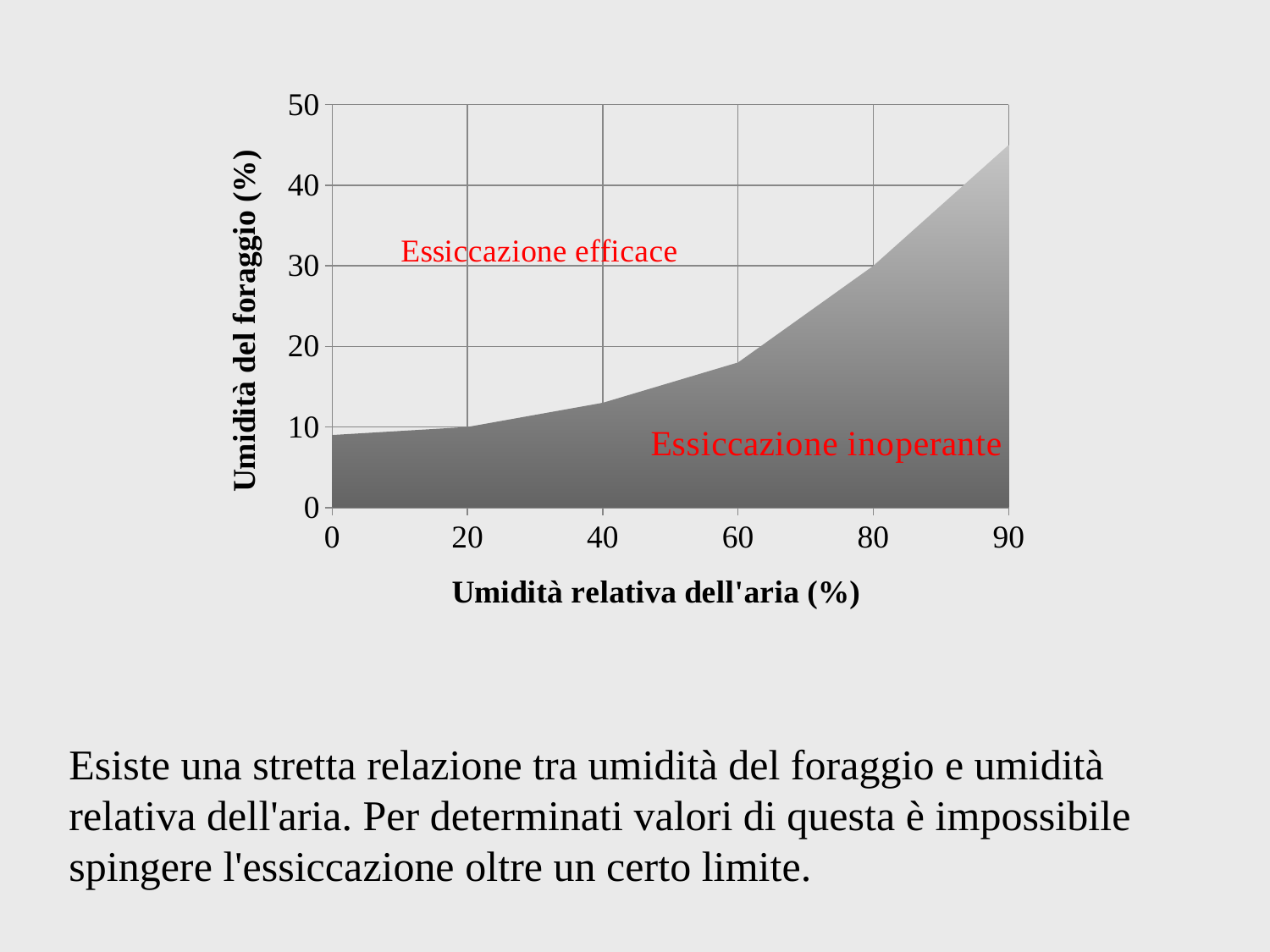
Is the forage humidity value at 90% relative air humidity greater or less than 40? greater Does the forage humidity (Umidità del foraggio) rise or fall as relative air humidity increases along the x axis? rise Is the forage humidity value at 80% relative air humidity greater or less than 40? less At which relative air humidity value on the x axis is the forage humidity highest? 90 Is the forage humidity value at 40% relative air humidity greater or less than 10? greater What is the label of the x axis? Umidità relativa dell'aria (%) Which has the higher forage humidity value: 60% or 80% relative air humidity? 80% What label is written in red in the shaded region below the curve? Essiccazione inoperante What kind of chart is shown on the slide? area chart At which relative air humidity value on the x axis is the forage humidity lowest? 0